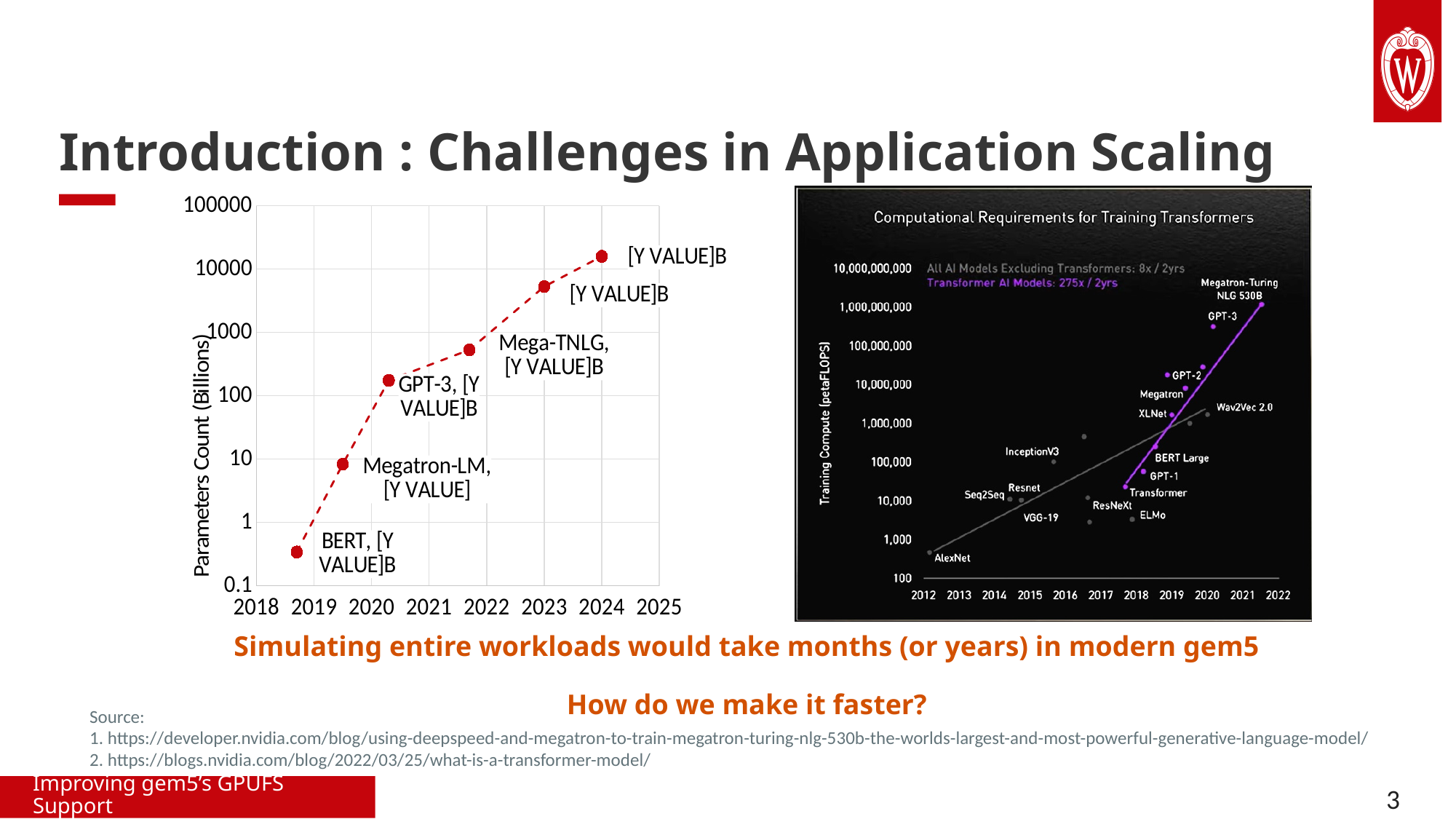
What is the title of the chart on the right? Computational Requirements for Training Transformers In the left chart, which labeled model has the lowest parameter count? BERT In the right chart, is the training compute for AlexNet greater or less than 1,000 petaFLOPS? less In the left chart, do the parameter counts rise or fall as the years increase from 2018 to 2024? Rise In the left chart, which has the larger parameter count, Megatron-LM or GPT-3? GPT-3 In the left chart, how many data points are plotted? 6 In the left chart, is the value for Mega-TNLG greater or less than 1000? less In the left chart, what kind of chart is used to show Parameters Count (Billions) over the years? Line chart In the left chart, what is the label of the y axis? Parameters Count (Billions) In the right chart, which model has the highest training compute? Megatron-Turing NLG 530B In the left chart, is the value for GPT-3 greater or less than 100? greater